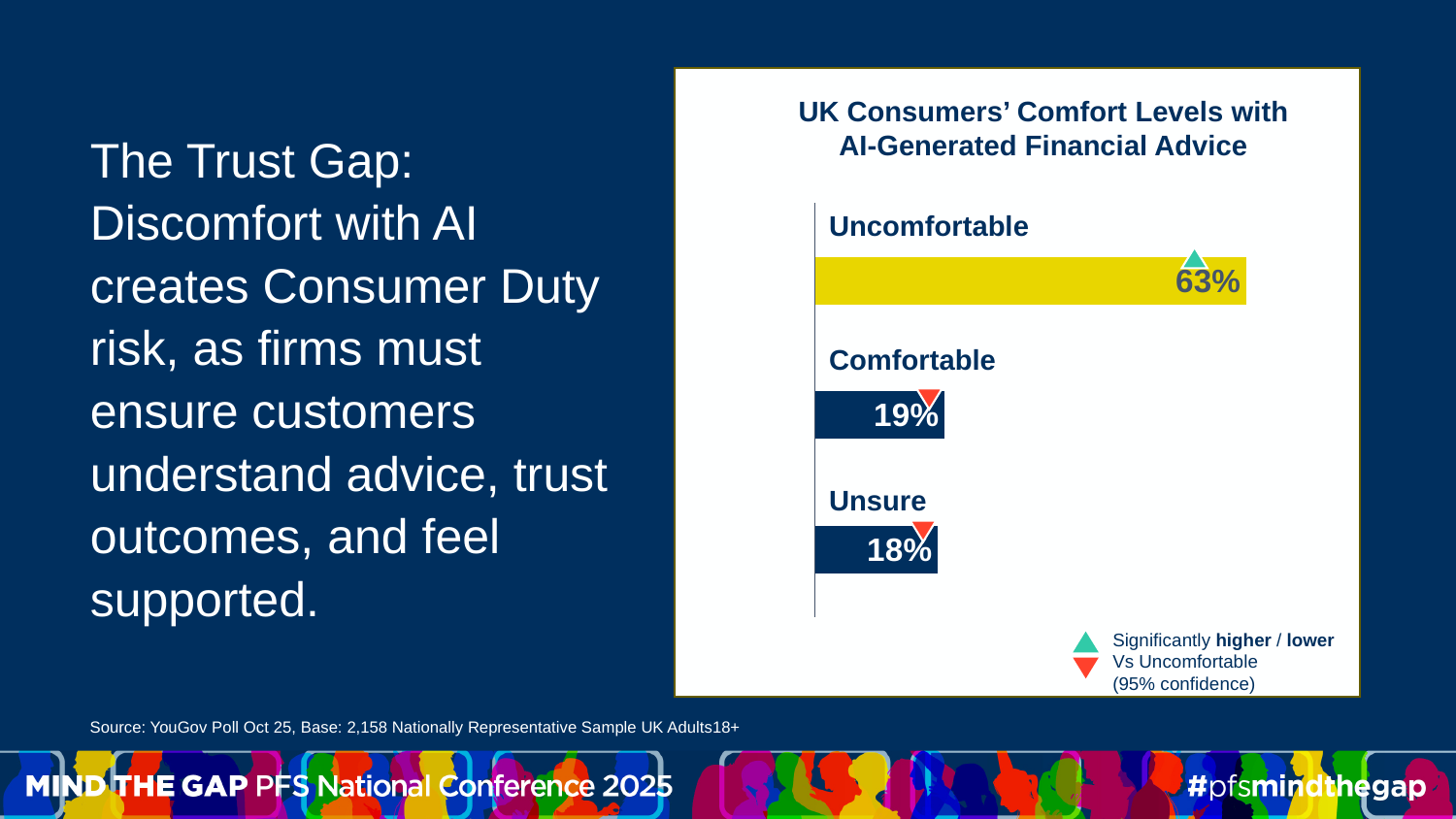
What percentage of UK consumers are Comfortable with AI-generated financial advice? 19% Which is larger, the value for Uncomfortable or the value for Comfortable? Uncomfortable What is the difference between the Comfortable and Unsure percentages? 1% Which category has the lowest value in the chart? Unsure What is the difference between the Uncomfortable and Comfortable percentages? 44% Which bar in the chart is coloured yellow? Uncomfortable Which category has the highest value in the chart? Uncomfortable What percentage of UK consumers are Uncomfortable with AI-generated financial advice? 63% What type of chart is shown on the slide? Bar chart What is the title of the chart? UK Consumers' Comfort Levels with AI-Generated Financial Advice How many categories are shown in the chart? 3 What percentage of UK consumers are Unsure about AI-generated financial advice? 18%